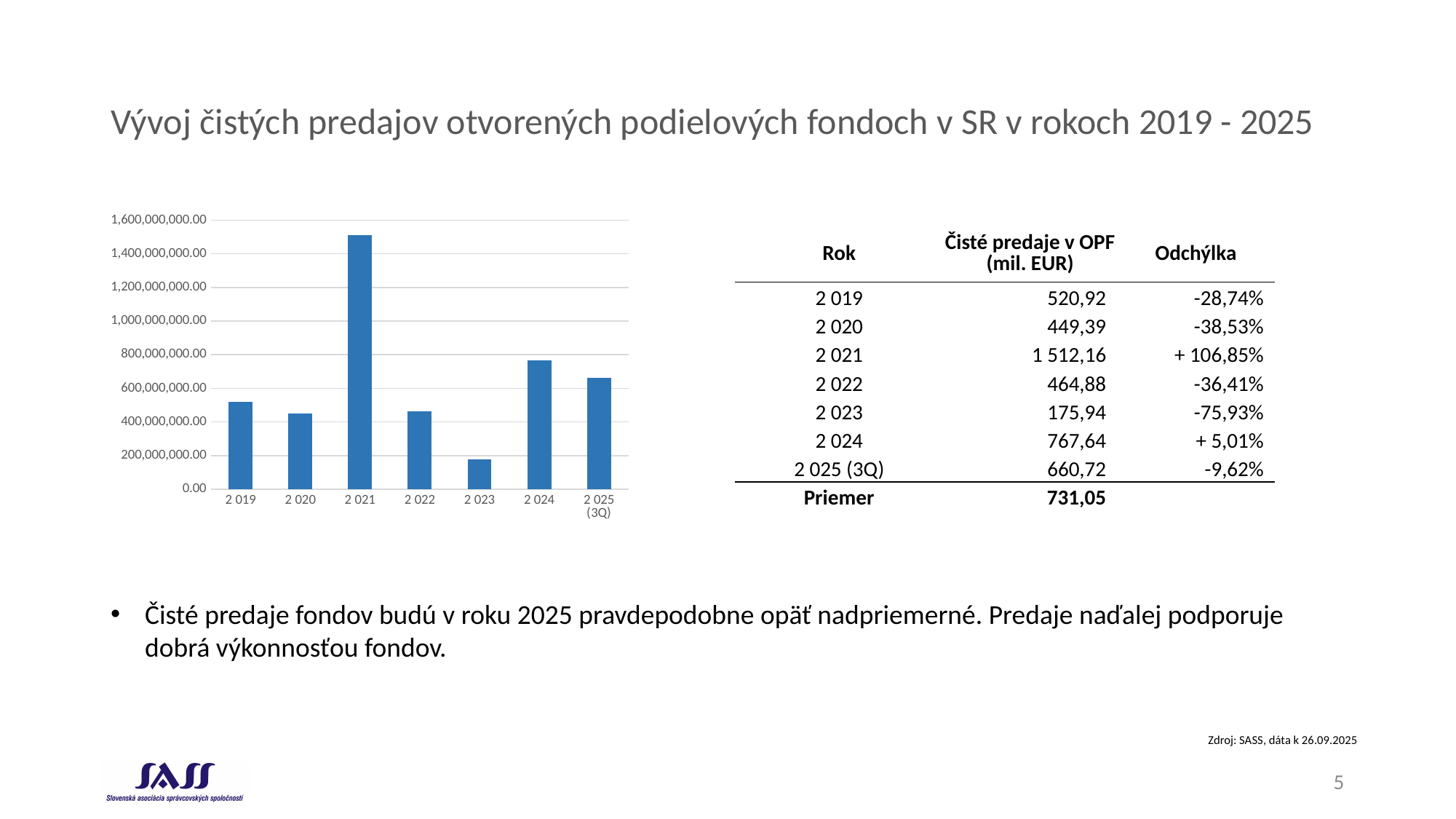
According to the table next to the chart, what are the net sales (Čisté predaje v OPF) for 2 021 in mil. EUR? 1 512,16 How many bars (years) does the chart show? 7 Is the value for 2 024 greater or less than 600,000,000.00? greater Which year has the lowest bar in the chart? 2 023 Is the value for 2 023 greater or less than 200,000,000.00? less Do the bar values rise or fall from 2 021 to 2 023? fall Is the value for 2 021 greater or less than 1,400,000,000.00? greater What kind of chart is shown on the slide? bar chart Which year has the highest bar in the chart? 2 021 Which bar is taller, 2 024 or 2 025 (3Q)? 2 024 Which bar is taller, 2 019 or 2 020? 2 019 According to the table next to the chart, what is the Odchýlka for 2 023? -75,93%